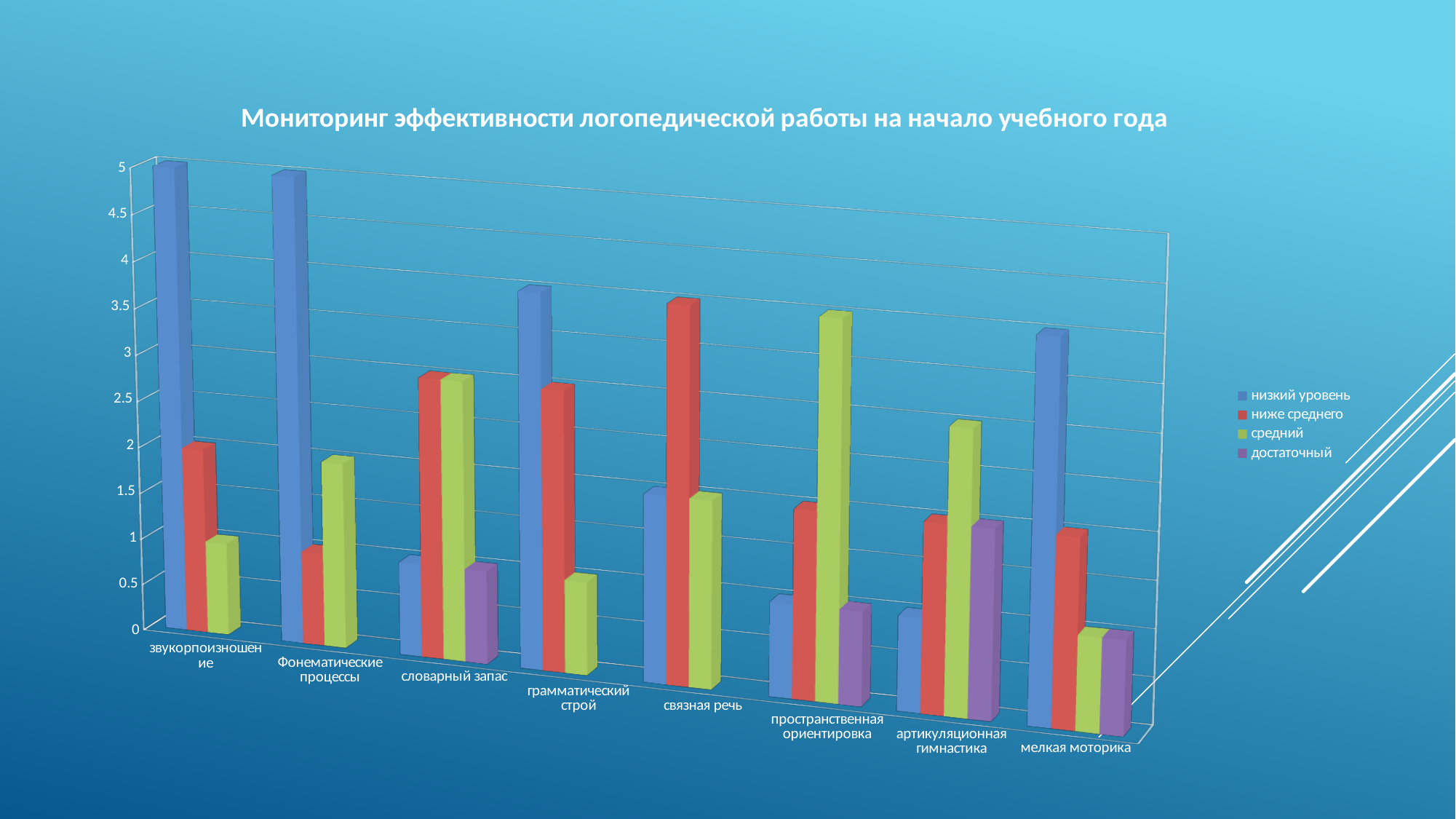
Is the value for 'низкий уровень' in the category 'звукорпоизношение' greater or less than 4? greater Is the value for 'низкий уровень' in the category 'артикуляционная гимнастика' greater or less than 1.5? less What type of chart is shown on the slide? bar chart Which colour represents the series 'достаточный' in the legend? purple Is the value for 'средний' in the category 'пространственная ориентировка' greater or less than 2.5? greater In the category 'звукорпоизношение', which is larger: 'низкий уровень' or 'ниже среднего'? низкий уровень How many series does the legend list? 4 What is the title of the chart? Мониторинг эффективности логопедической работы на начало учебного года How many categories are shown on the x axis? 8 In the category 'связная речь', which series has the highest value? ниже среднего